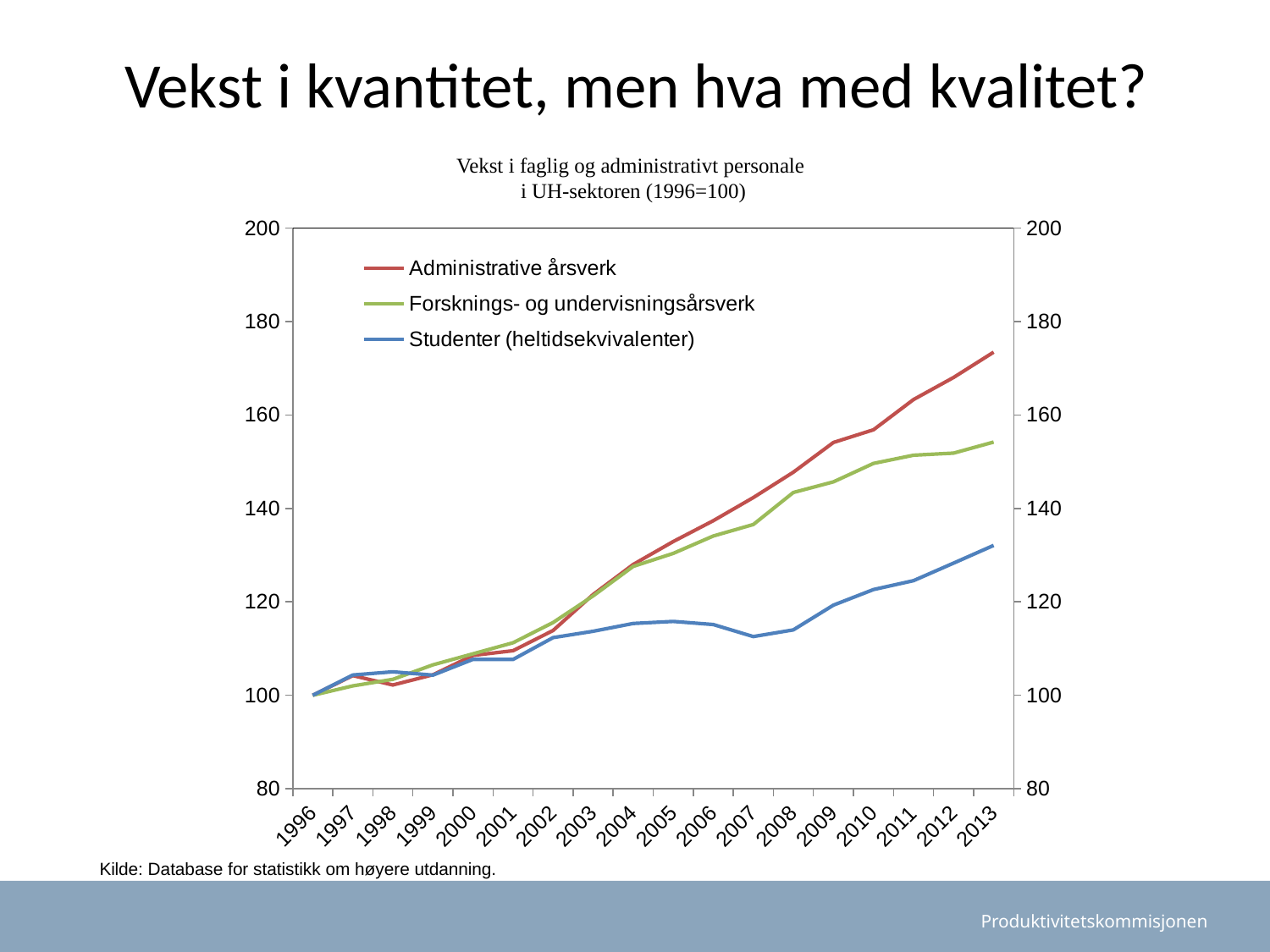
Is the value for Studenter (heltidsekvivalenter) in 2007 greater or less than 120? less What kind of chart is shown on the slide? Line chart Which series has the highest value in 2013? Administrative årsverk In 2013, which is larger: Forsknings- og undervisningsårsverk or Studenter (heltidsekvivalenter)? Forsknings- og undervisningsårsverk What is the value of Administrative årsverk in 1996? 100 How many years are shown along the x axis? 18 Does the Administrative årsverk line rise or fall from 1996 to 2013? Rise Which series has the lowest value in 2013? Studenter (heltidsekvivalenter) Is the value for Administrative årsverk in 2013 greater or less than 160? greater How many series does the legend list? 3 What colour is the line for Studenter (heltidsekvivalenter)? Blue Is the value for Studenter (heltidsekvivalenter) in 2013 greater or less than 140? less